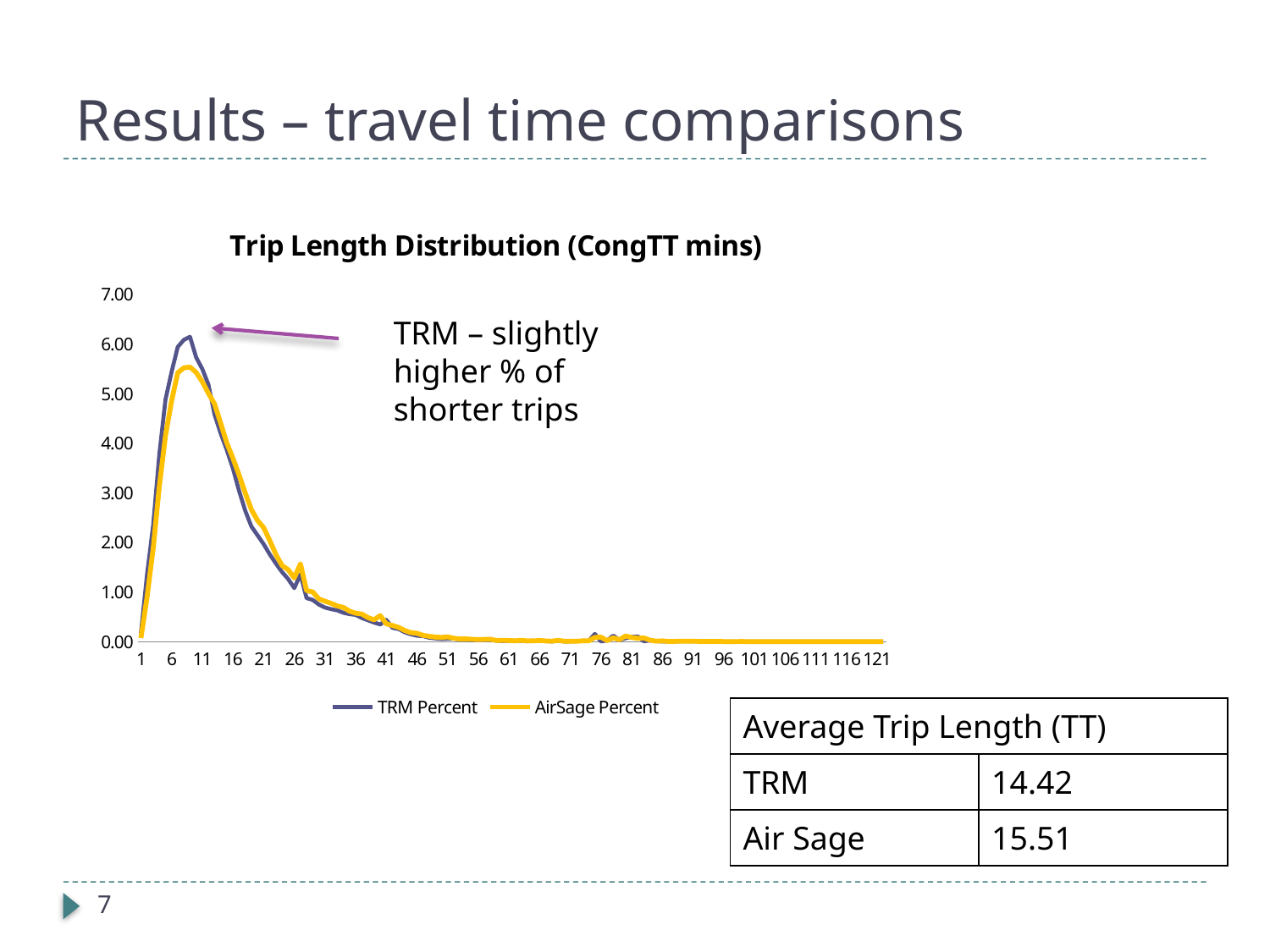
After the peak near the start of the x axis, do the values of both series rise or fall as the x axis increases? fall What kind of chart is shown on the slide? line chart Which series reaches the higher peak, TRM Percent or AirSage Percent? TRM Percent Is the peak value of the AirSage Percent series greater or less than 5.00? greater What is the title of the chart? Trip Length Distribution (CongTT mins) Is the value of the AirSage Percent series at 61 greater or less than 1.00? less Which series is drawn in yellow? AirSage Percent What is the highest value shown on the y axis? 7.00 Is the peak value of the TRM Percent series greater or less than 6.00? greater How many series does the chart's legend list? 2